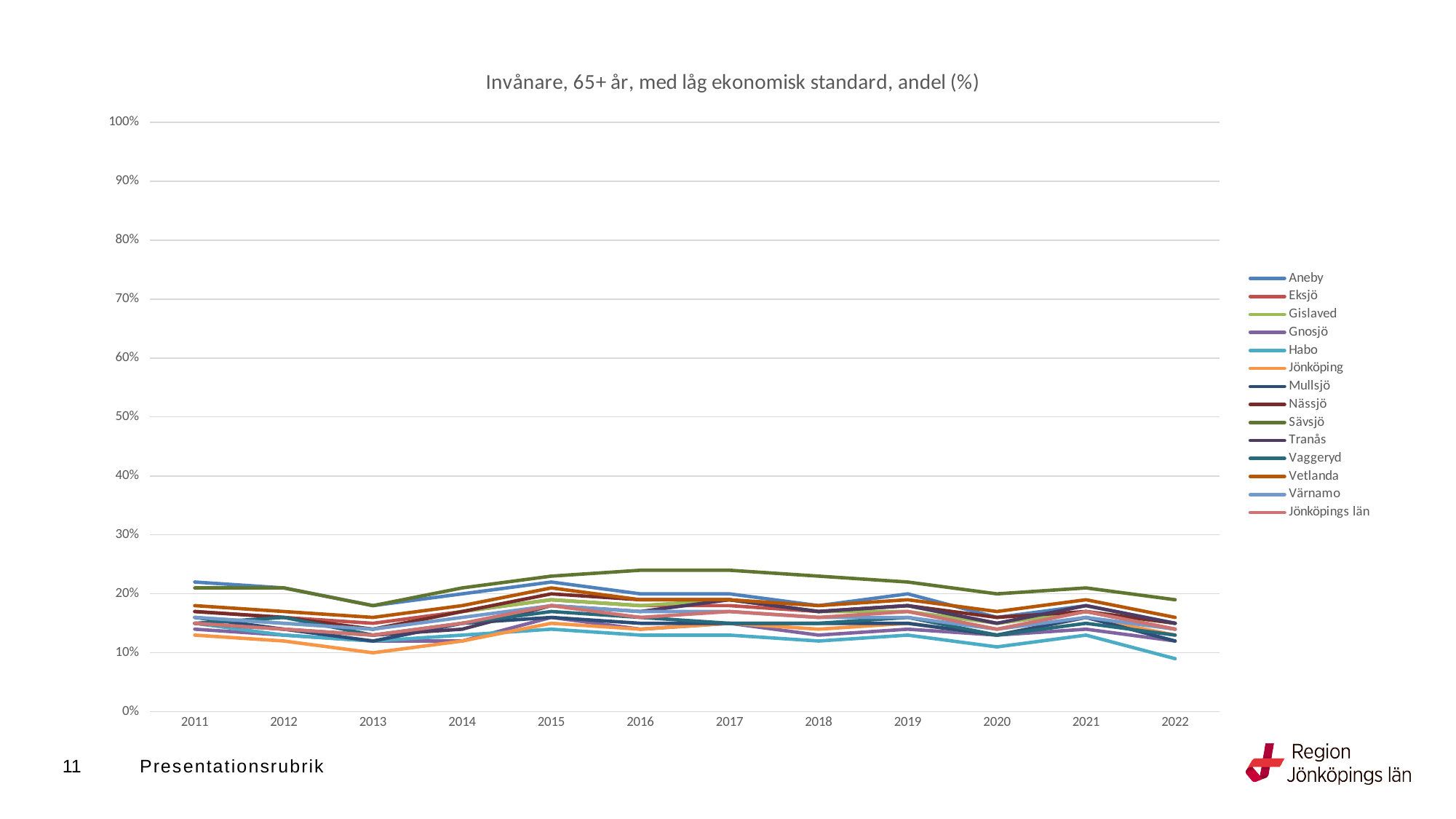
How many years are shown on the x axis? 12 What kind of chart is shown on the slide? line chart Which is larger in 2017, the value for Sävsjö or the value for Habo? Sävsjö Does the value for Sävsjö rise or fall from 2013 to 2016? rise Is the value for Sävsjö in 2016 greater or less than 20%? greater Which series has the lowest value in 2022? Habo Does the value for Habo rise or fall from 2021 to 2022? fall Is the value for Habo in 2022 greater or less than 10%? less Is the value for Sävsjö in 2013 greater or less than 20%? less Which series has the highest value in 2016? Sävsjö How many series does the legend list? 14 What is the title of the chart? Invånare, 65+ år, med låg ekonomisk standard, andel (%)